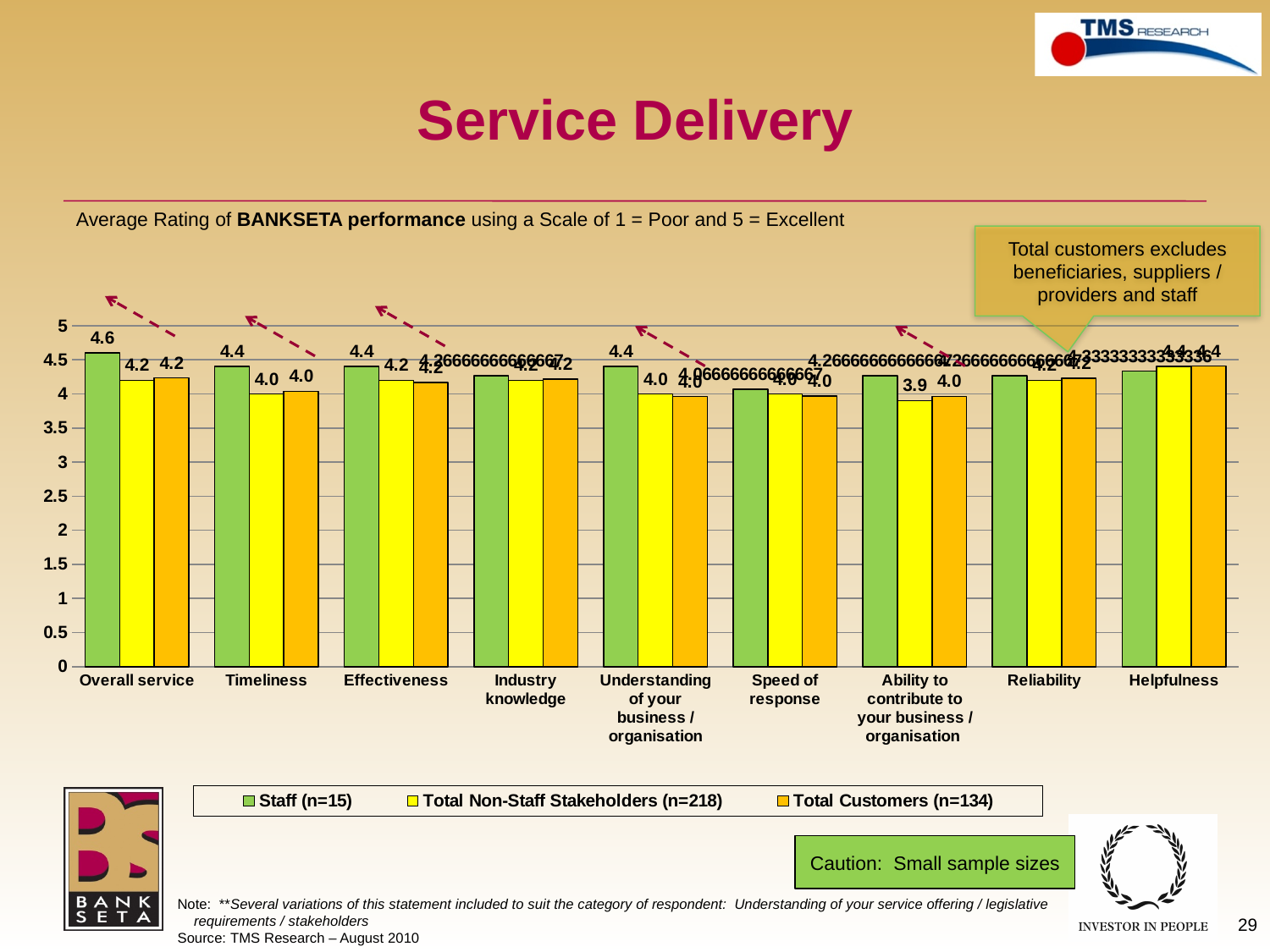
What is the Staff (n=15) rating for Timeliness? 4.4 How many series does the chart legend list? 3 What type of chart is shown on the slide? Bar chart What is the difference between the Staff (n=15) and Total Non-Staff Stakeholders (n=218) ratings for Overall service? 0.4 Which category has the lowest Total Non-Staff Stakeholders (n=218) rating? Ability to contribute to your business / organisation Is the Staff (n=15) rating for Overall service greater or less than 4? greater What is the Total Non-Staff Stakeholders (n=218) rating for Ability to contribute to your business / organisation? 3.9 Which category has the highest Staff (n=15) rating? Overall service What is the Staff (n=15) rating for Overall service? 4.6 For Ability to contribute to your business / organisation, which is larger: the Total Non-Staff Stakeholders (n=218) rating or the Total Customers (n=134) rating? Total Customers (n=134) How many categories are shown on the x axis of the chart? 9 What is the Total Customers (n=134) rating for Timeliness? 4.0